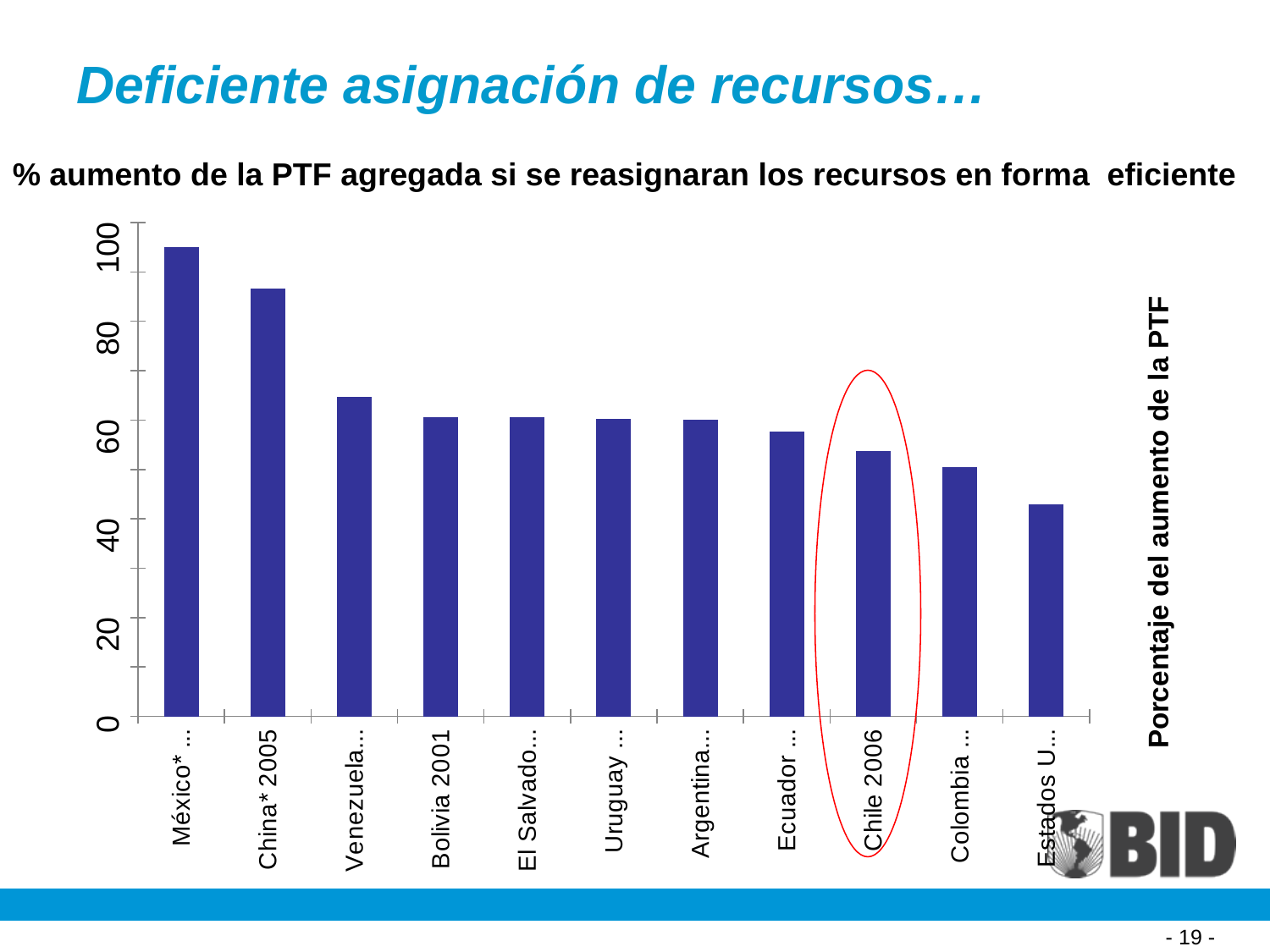
Is the value for China* 2005 greater or less than 80? greater Is the value for Chile 2006 greater or less than 60? less Which country has the highest bar in the chart? México* Do the bar values generally rise or fall from left to right along the x axis? fall Is the value for México* greater or less than 80? greater What kind of chart is shown on the slide? bar chart Which is larger, the value for China* 2005 or the value for Venezuela? China* 2005 Which country has the lowest bar in the chart? Estados U... Which is larger, the value for Chile 2006 or the value for Estados U...? Chile 2006 How many bars (countries) are plotted in the chart? 11 What is the label on the vertical axis of the chart? Porcentaje del aumento de la PTF